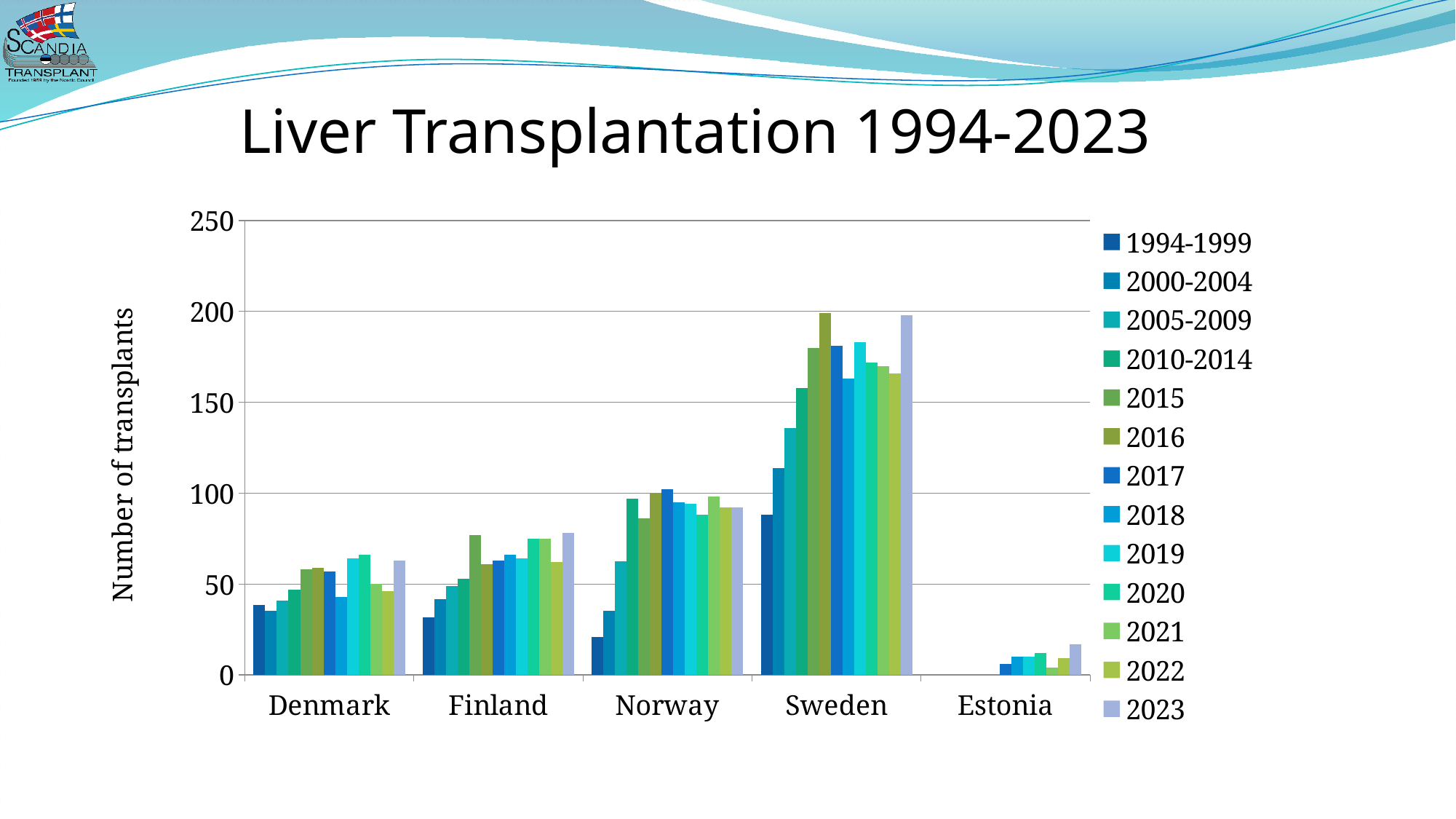
For Norway, which period has the lowest number of transplants? 1994-1999 How many series does the chart's legend list? 13 Does the number of transplants for Sweden rise or fall from 1994-1999 through 2016? Rise Which is larger: the value for Finland in 2023 or the value for Denmark in 2023? Finland in 2023 Is the value for Estonia in 2023 greater or less than 50? less Which country has the lowest number of liver transplants for 2023? Estonia What kind of chart is shown on the slide? Bar chart Which country has the highest number of liver transplants for 2023? Sweden Is the value for Sweden in 2016 greater or less than 150? greater Is the value for Sweden in 1994-1999 greater or less than 100? less What is the label on the y axis of the chart? Number of transplants How many countries are shown on the x axis of the chart? 5